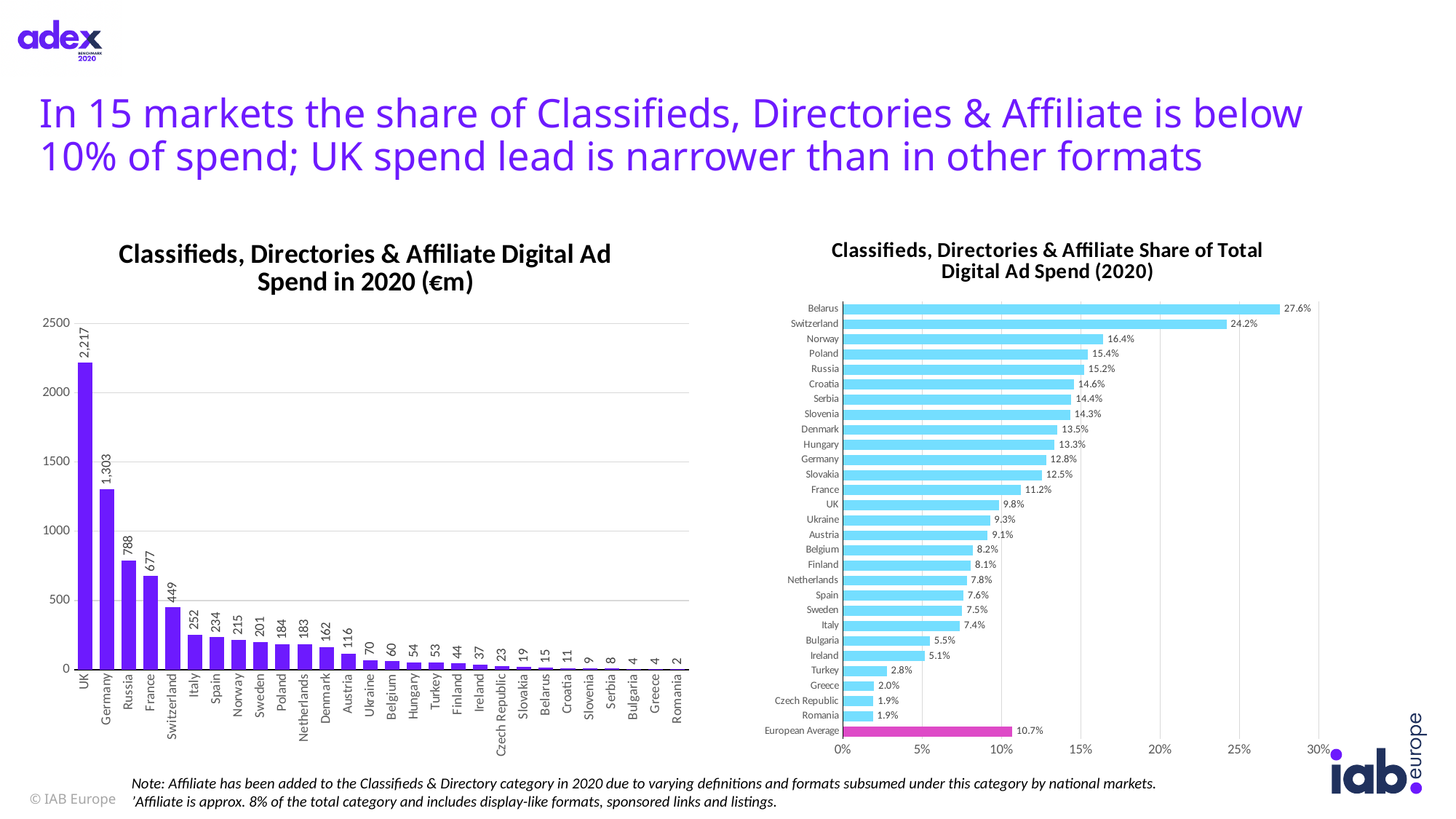
In the right chart, Classifieds, Directories & Affiliate Share of Total Digital Ad Spend (2020), which country has the highest share? Belarus In the left chart, Classifieds, Directories & Affiliate Digital Ad Spend in 2020 (€m), what is the value for Germany? 1,303 In the left chart, Classifieds, Directories & Affiliate Digital Ad Spend in 2020 (€m), which country has the lowest spend? Romania What kind of chart is the right chart, Classifieds, Directories & Affiliate Share of Total Digital Ad Spend (2020)? Bar chart In the right chart, Classifieds, Directories & Affiliate Share of Total Digital Ad Spend (2020), what is the difference between the values for Norway and the UK? 6.6% In the left chart, Classifieds, Directories & Affiliate Digital Ad Spend in 2020 (€m), which is larger, the value for Italy or the value for Spain? Italy In the left chart, Classifieds, Directories & Affiliate Digital Ad Spend in 2020 (€m), what is the difference between the values for Russia and France? 111 In the right chart, Classifieds, Directories & Affiliate Share of Total Digital Ad Spend (2020), what is the value for the European Average? 10.7% In the left chart, Classifieds, Directories & Affiliate Digital Ad Spend in 2020 (€m), how many countries are shown? 28 In the left chart, Classifieds, Directories & Affiliate Digital Ad Spend in 2020 (€m), which country has the highest spend? UK In the right chart, Classifieds, Directories & Affiliate Share of Total Digital Ad Spend (2020), what colour is the European Average bar? Pink In the right chart, Classifieds, Directories & Affiliate Share of Total Digital Ad Spend (2020), what is the value for Switzerland? 24.2%